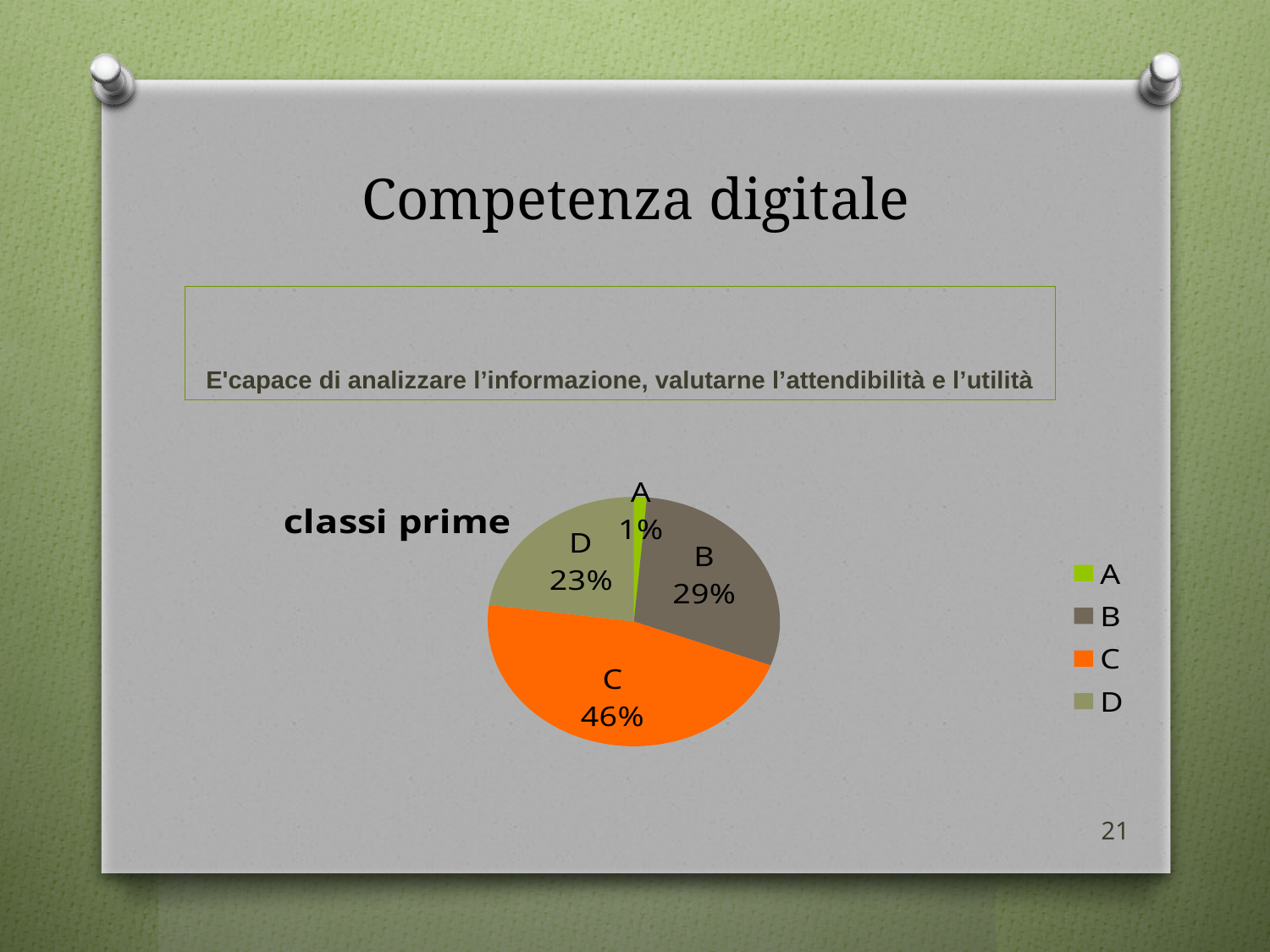
What is the difference in percentage points between C and B? 17 What percentage does slice A represent? 1% Which category has the largest share of the pie? C What colour is the slice for category C? orange How many categories does the legend list? 4 What percentage does slice B represent? 29% What percentage does slice C represent? 46% What type of chart is shown on the slide? pie chart What percentage does slice D represent? 23% Which is larger, the share for B or the share for D? B What is the title of the chart? classi prime Which category has the smallest share of the pie? A